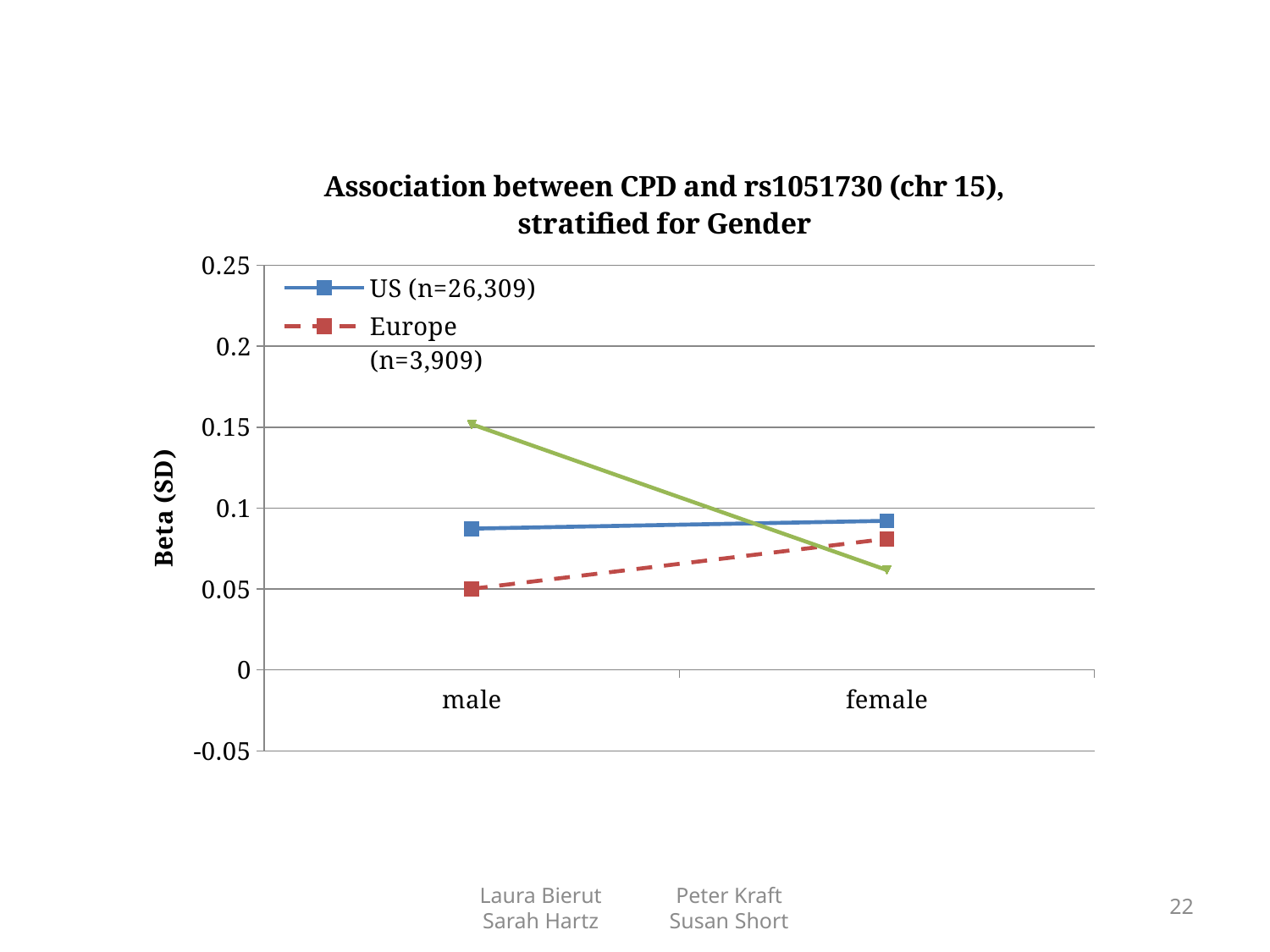
For the Europe (n=3,909) series, which category has the higher value, male or female? female What is the label of the y axis? Beta (SD) For male, which series has the larger value, US (n=26,309) or Europe (n=3,909)? US (n=26,309) Is the value for US (n=26,309) for female greater or less than 0.15? less Is the value for Europe (n=3,909) for male greater or less than 0.1? less Is the value for Europe (n=3,909) for female greater or less than 0.05? greater How many categories are shown on the x axis? 2 What kind of chart is shown on the slide? line chart What is the title of the chart? Association between CPD and rs1051730 (chr 15), stratified for Gender Does the Europe (n=3,909) series rise or fall from male to female? rise How many series does the chart's legend list? 2